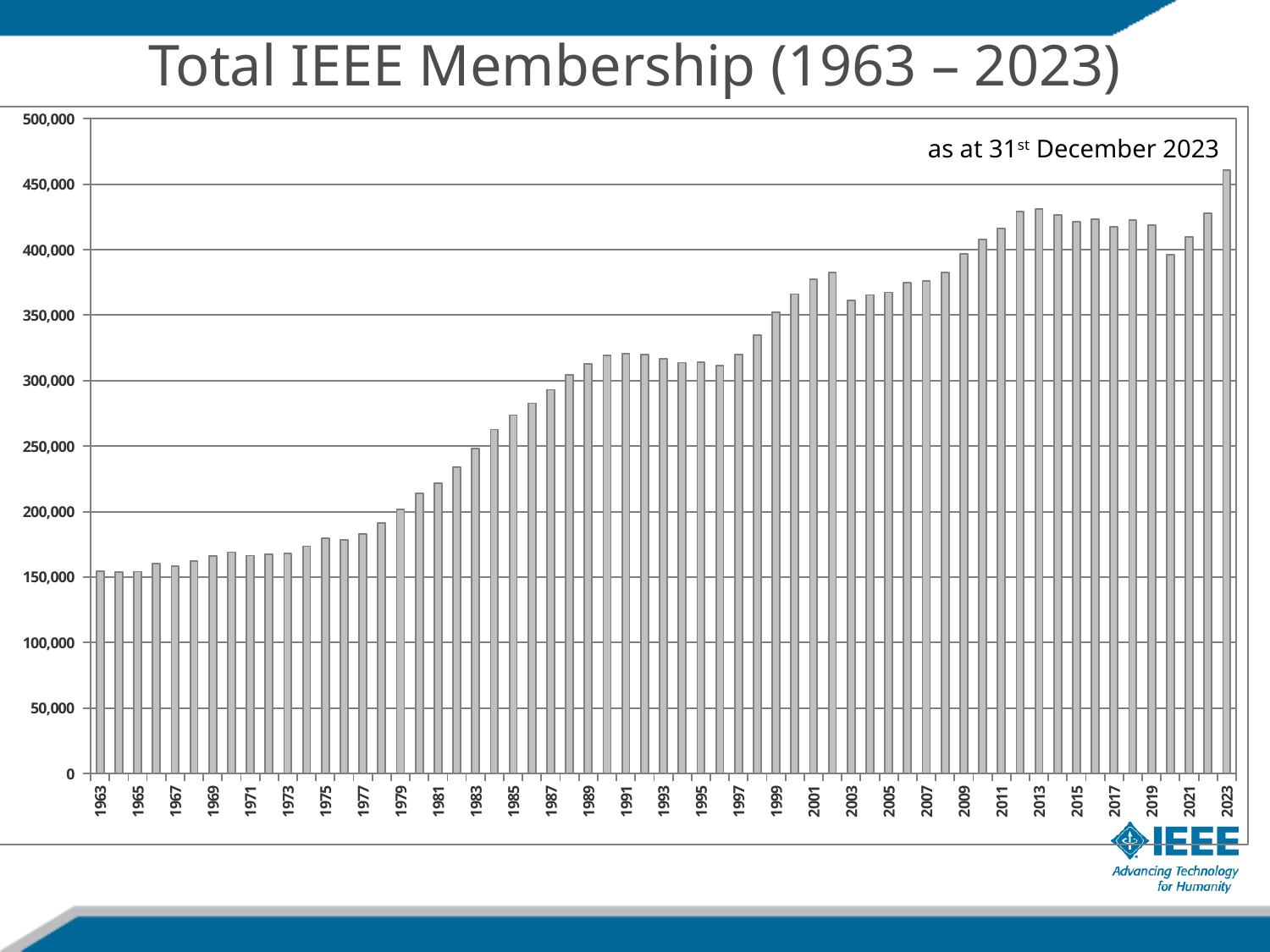
What kind of chart is shown on the slide? bar chart Is the value for 2001 greater or less than 400,000? less Which year has the larger membership, 1963 or 2023? 2023 Is the value for 2013 greater or less than 400,000? greater Which year has the larger membership, 2001 or 2003? 2001 Is the value for 2023 greater or less than 450,000? greater Overall, does total IEEE membership rise or fall from 1963 to 2023? rise Which year has the highest total IEEE membership? 2023 What is the title of the chart? Total IEEE Membership (1963 – 2023)